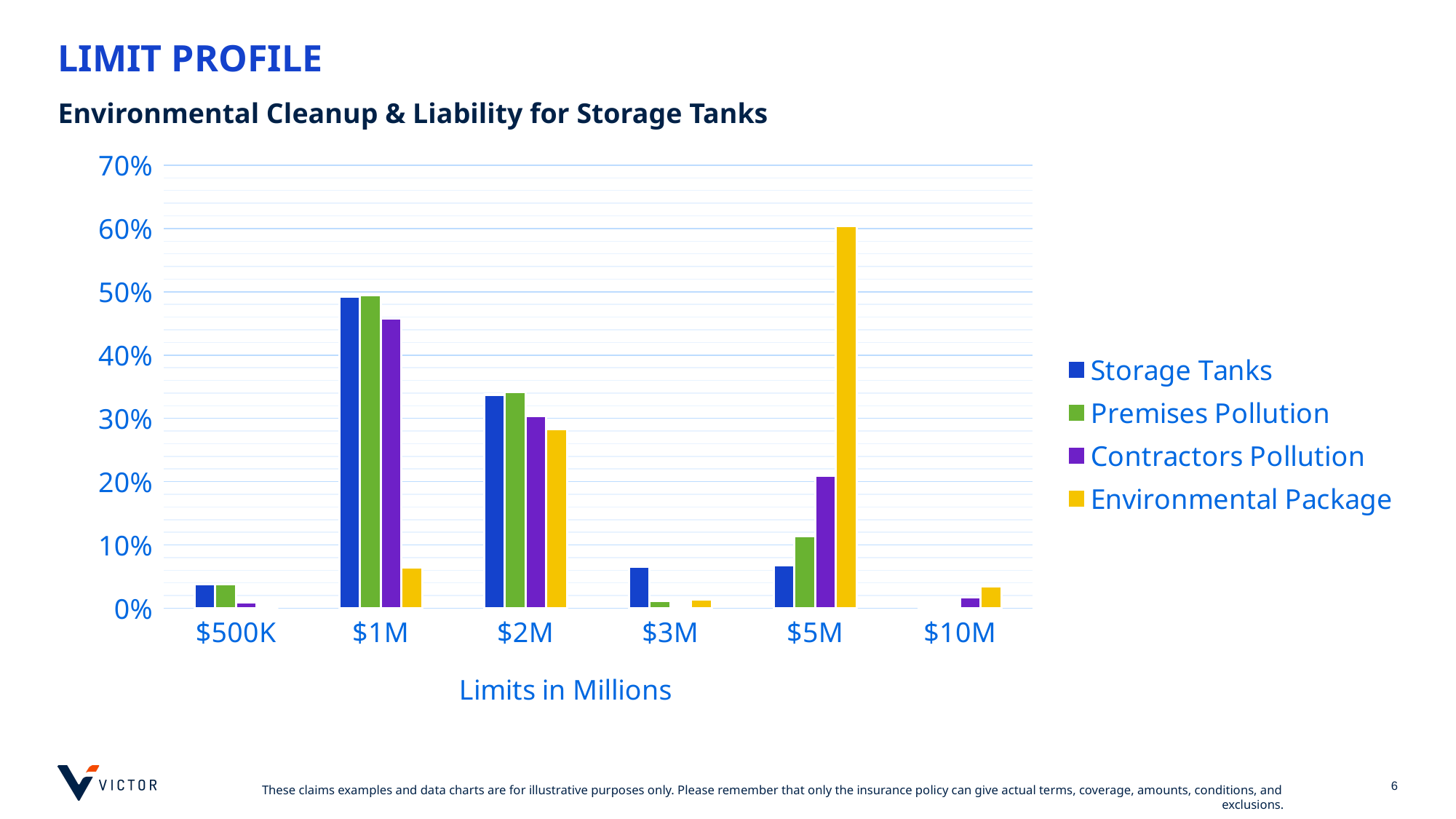
At the $2M limit, which is larger: Storage Tanks or Environmental Package? Storage Tanks Is the value for Environmental Package at $5M greater or less than 50%? greater At which limit is the Storage Tanks bar the tallest? $1M What type of chart is shown on the slide? bar chart How many series does the legend list? 4 At which limit is the Environmental Package bar the tallest? $5M At which limit is the Contractors Pollution bar the tallest? $1M At the $5M limit, which is larger: Environmental Package or Storage Tanks? Environmental Package Is the value for Premises Pollution at $5M greater or less than 20%? less How many limit categories are shown on the x axis? 6 What is the title of the x axis? Limits in Millions Is the value for Contractors Pollution at $1M greater or less than 40%? greater